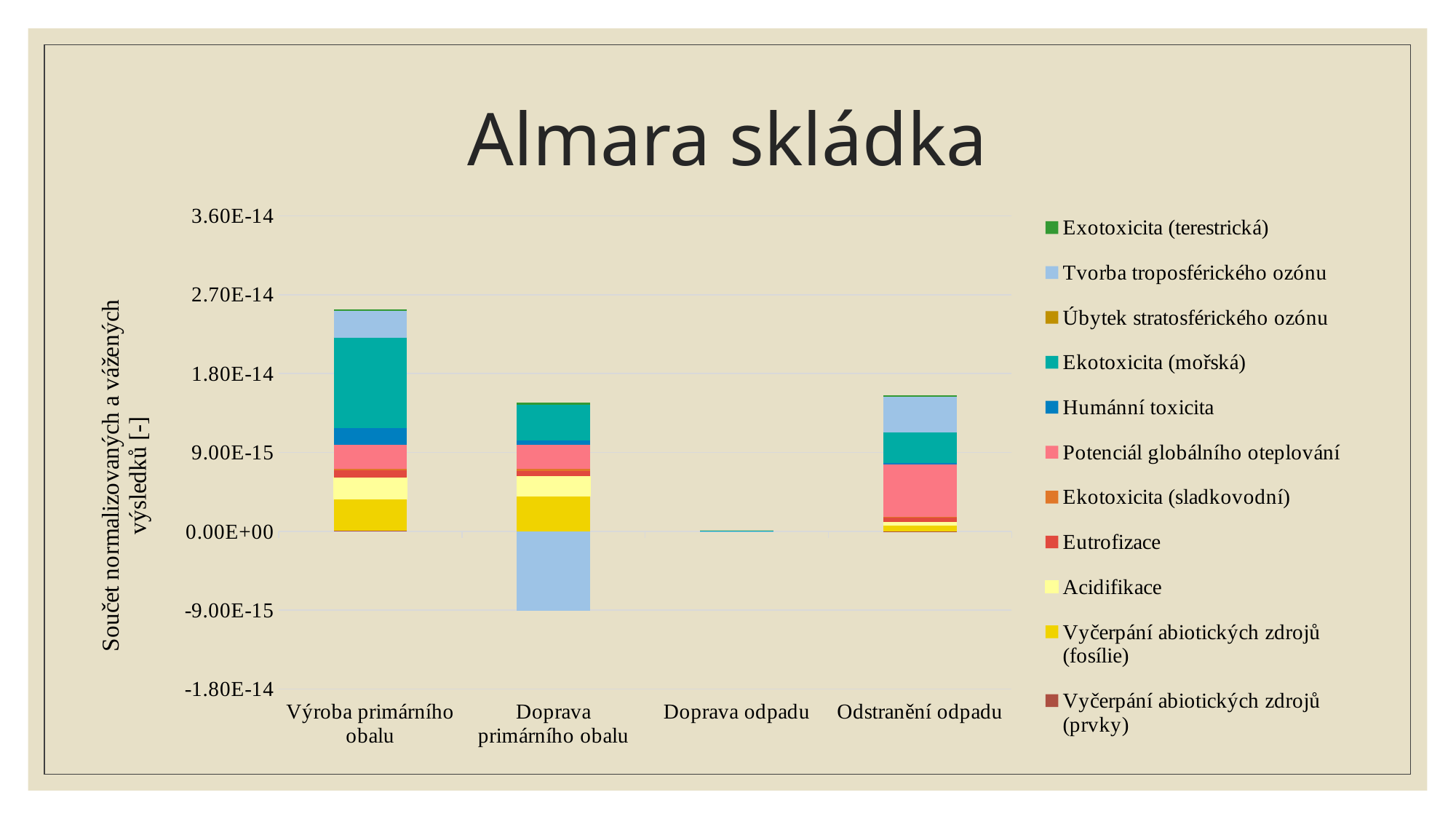
Which stacked bar is taller above zero: Výroba primárního obalu or Doprava odpadu? Výroba primárního obalu How many categories are shown on the x axis? 4 Is the top of the stacked bar for Výroba primárního obalu greater or less than 1.80E-14? greater What is the title of the chart? Almara skládka What kind of chart is shown on the slide? stacked bar chart Is the value for Doprava odpadu greater or less than 9.00E-15? less How many series does the legend list? 11 Is the top of the stacked bar for Doprava primárního obalu greater or less than 1.80E-14? less Which category has the smallest stacked bar? Doprava odpadu Which category has the tallest stacked bar above zero? Výroba primárního obalu Which category has a segment extending below zero? Doprava primárního obalu